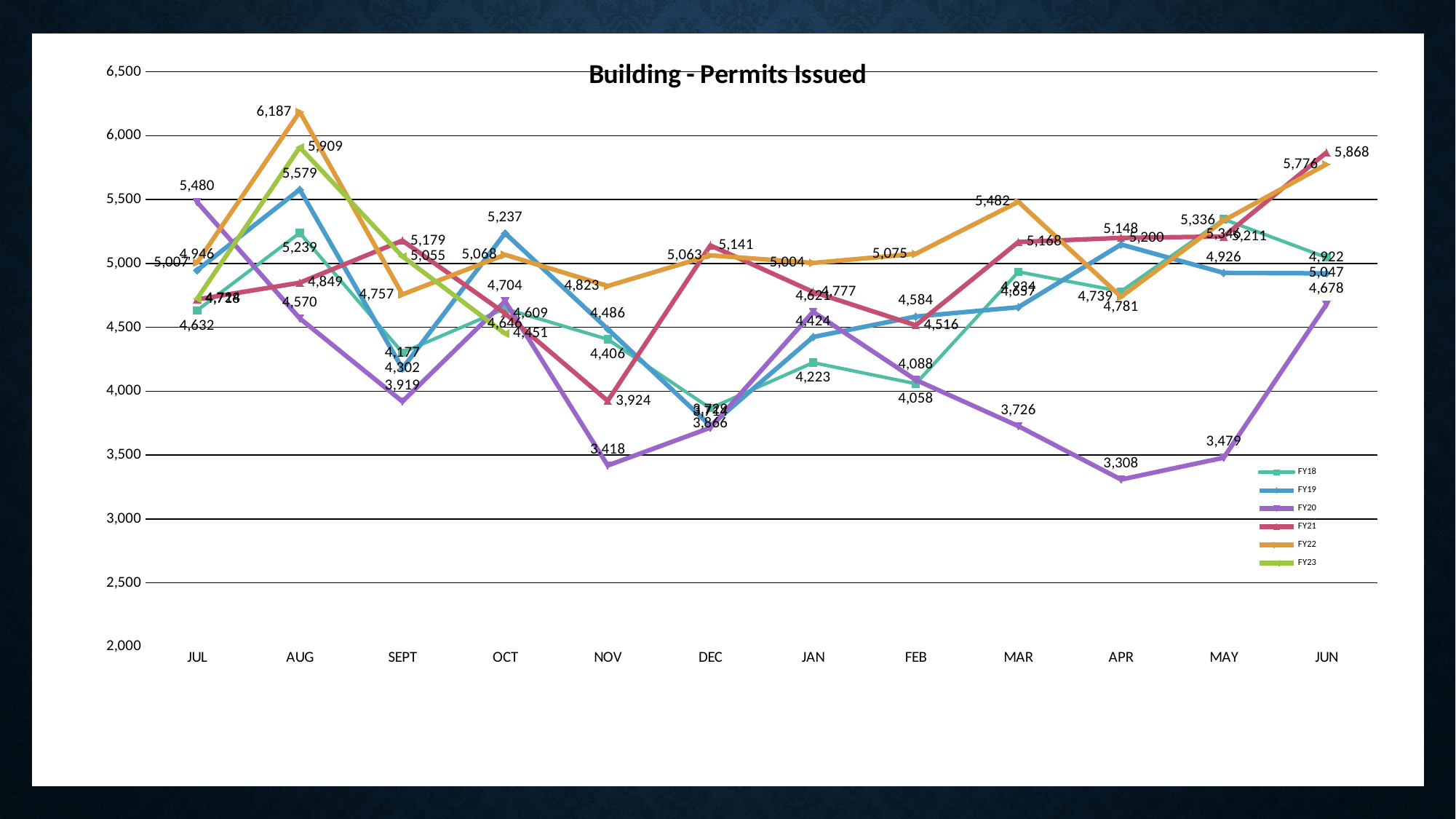
In which month does FY22 reach its highest value? AUG In which month does FY20 reach its lowest value? APR What type of chart is shown on the slide? line chart What is the FY21 value for JUN? 5,868 What is the FY22 value for AUG? 6,187 Which is larger for FY20: the JUL value or the AUG value? JUL What is the title of the chart? Building - Permits Issued What is the FY20 value for APR? 3,308 How many series does the legend list? 6 Is the FY20 value for MAR greater or less than 4,000? less How many months are shown on the x axis? 12 What is the difference between the FY22 and FY23 values for AUG? 278